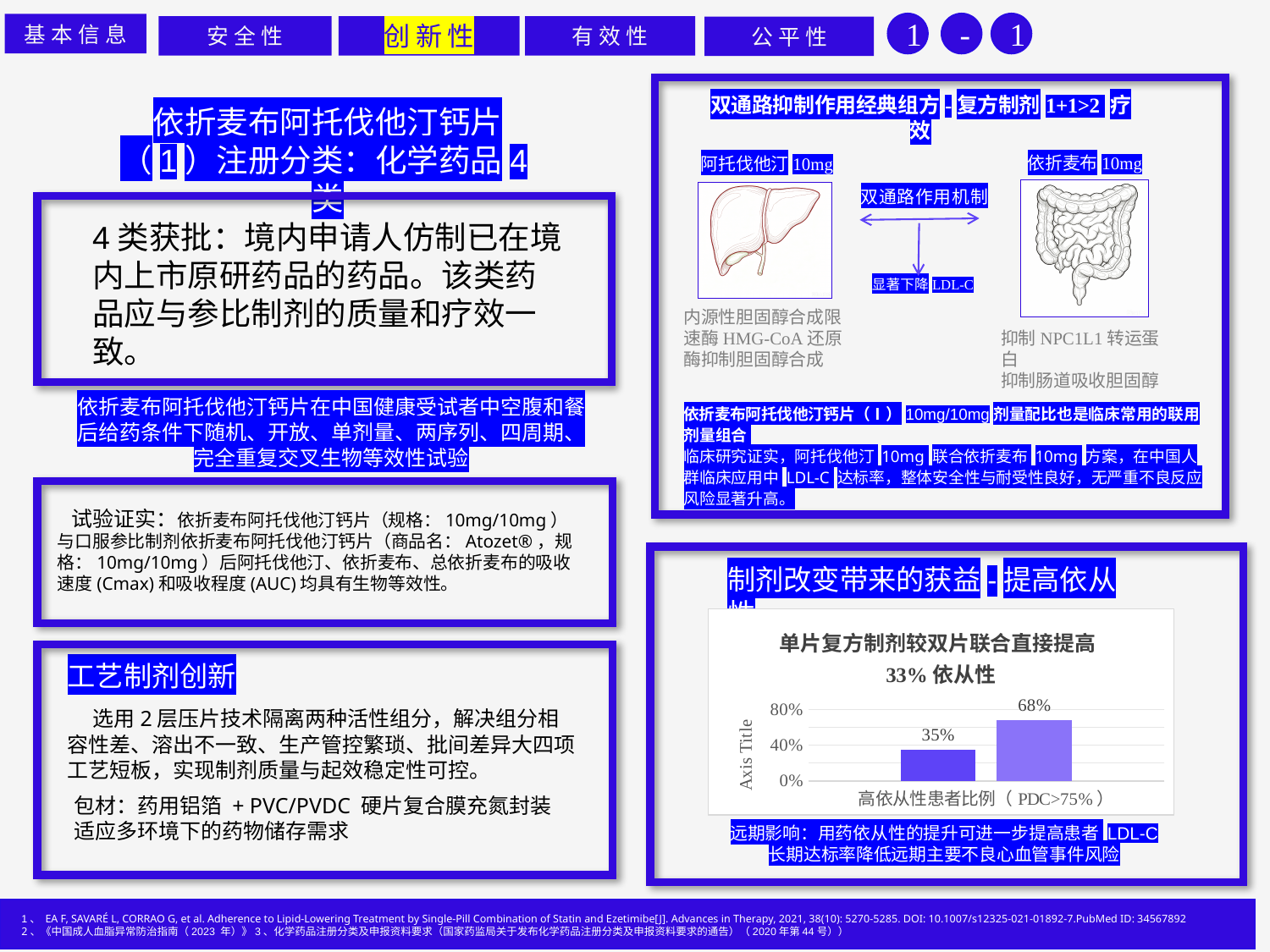
What is the title of the chart? 单片复方制剂较双片联合直接提高33%依从性 What is the difference between the two bar values in the chart? 33% Is the value of the left bar greater or less than 40%? less Which bar in the chart is higher, the left one or the right one? the right one What is the value shown on the right bar of the chart? 68% What is the category label shown on the x axis of the chart? 高依从性患者比例（PDC>75%） What kind of chart is shown on the slide? bar chart How many bars are plotted in the chart? 2 What is the lowest value shown in the chart? 35% What is the value shown on the left bar of the chart? 35% Is the value of the right bar greater or less than 40%? greater What is the highest value shown in the chart? 68%